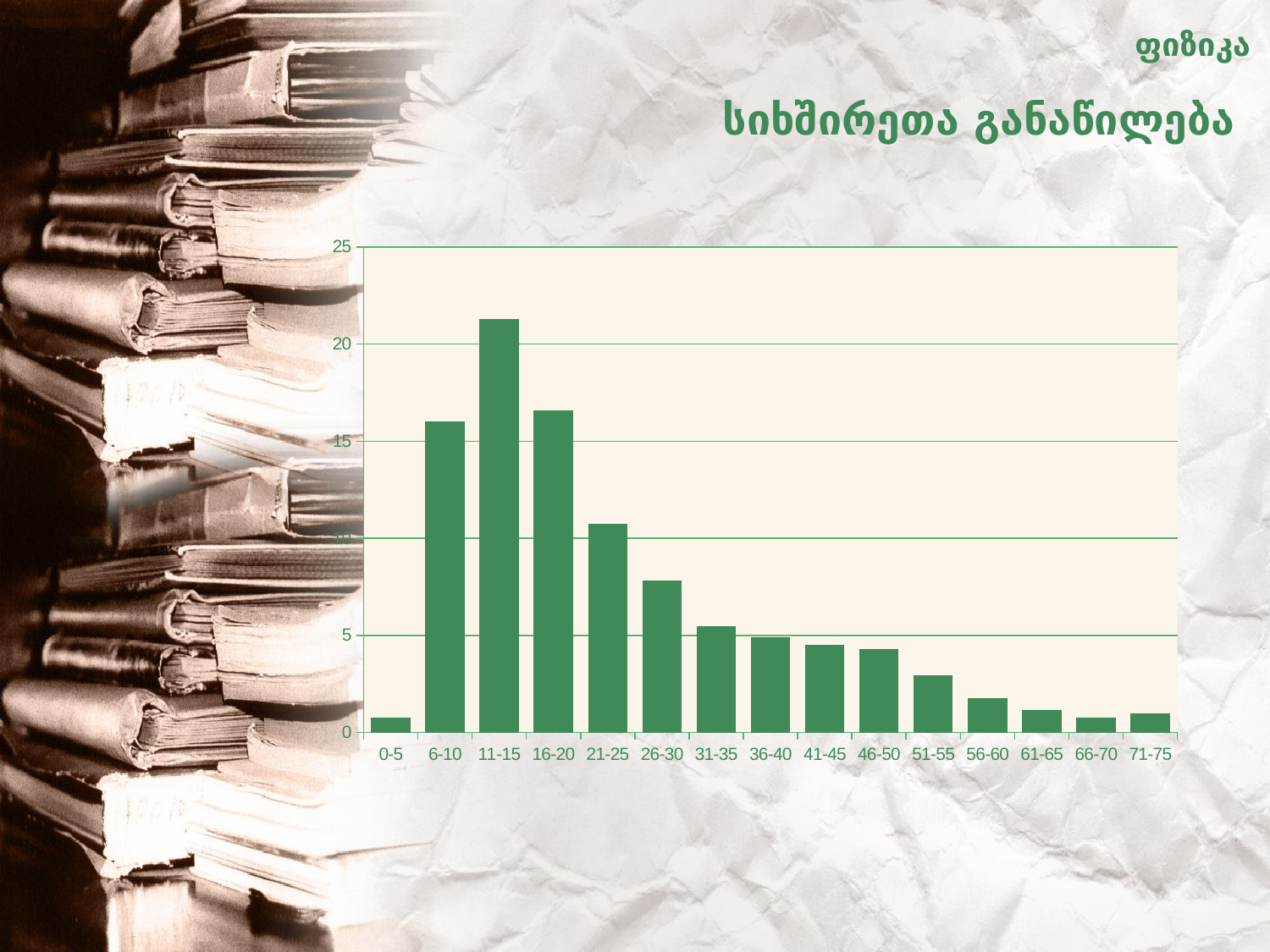
Which has the larger value, 51-55 or 56-60? 51-55 What colour are the bars in the chart? green Is the value for 0-5 greater or less than 5? less Is the value for 26-30 greater or less than 10? less Is the value for 11-15 greater or less than 20? greater What kind of chart is shown on the slide? bar chart Which category has the highest bar in the chart? 11-15 Do the values rise or fall along the x axis from 11-15 to 56-60? fall Which has the larger value, 21-25 or 26-30? 21-25 How many categories are shown on the x axis of the chart? 15